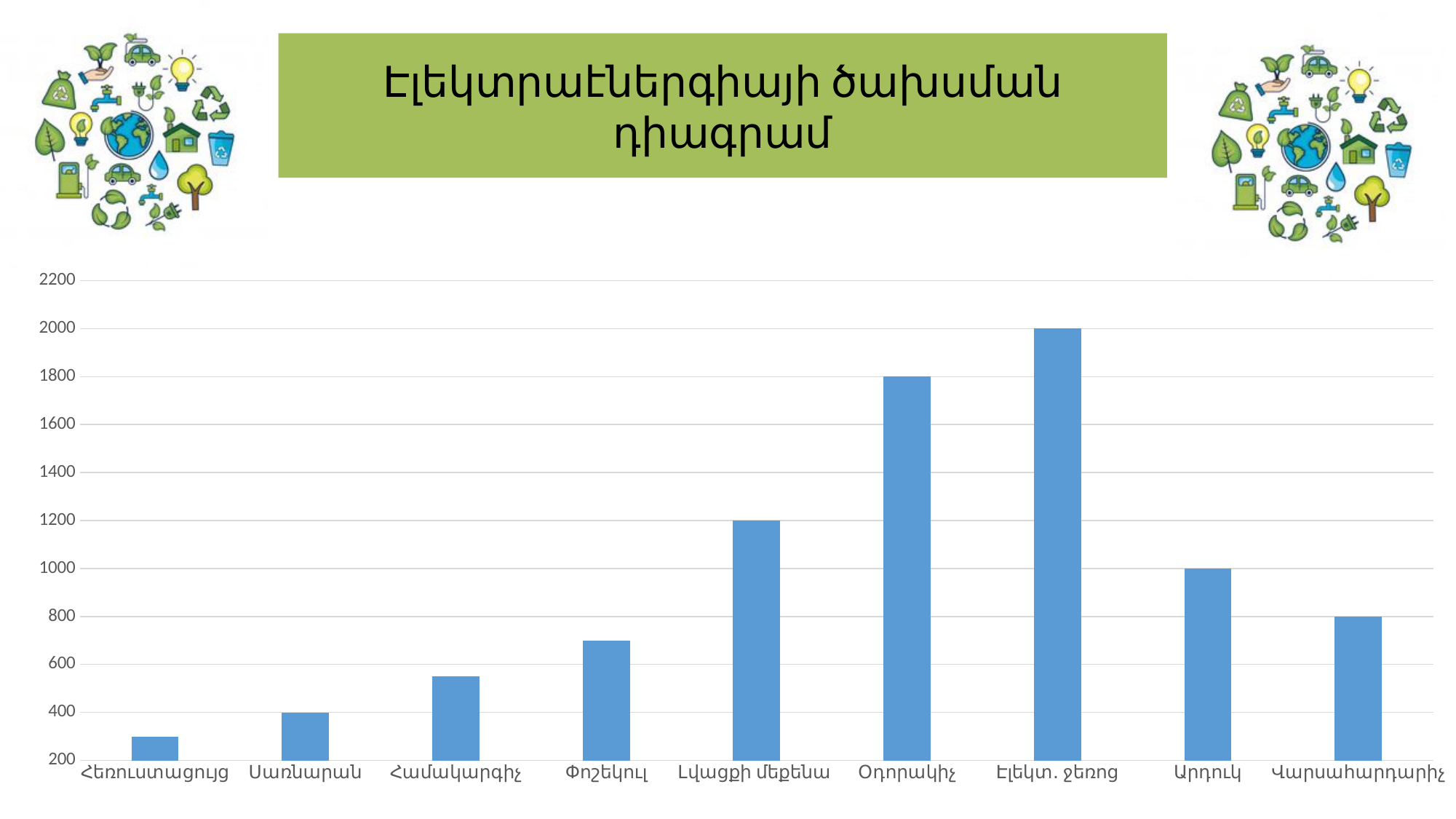
What is the value for Լվացքի մեքենա? 1200 What is the difference between the values for Արդուկ and Վարսահարդարիչ? 200 What is the value for Էլեկտ. ջեռոց? 2000 What is the value for Սառնարան? 400 Which is larger, the value for Համակարգիչ or the value for Վարսահարդարիչ? Վարսահարդարիչ Which category has the lowest value? Հեռուստացույց Is the value for Փոշեկուլ greater or less than 600? greater What is the title of the chart? Էլեկտրաէներգիայի ծախսման դիագրամ What kind of chart is shown on the slide? Bar chart How many categories are plotted on the x axis? 9 What is the value for Օդորակիչ? 1800 Which category has the highest value? Էլեկտ. ջեռոց